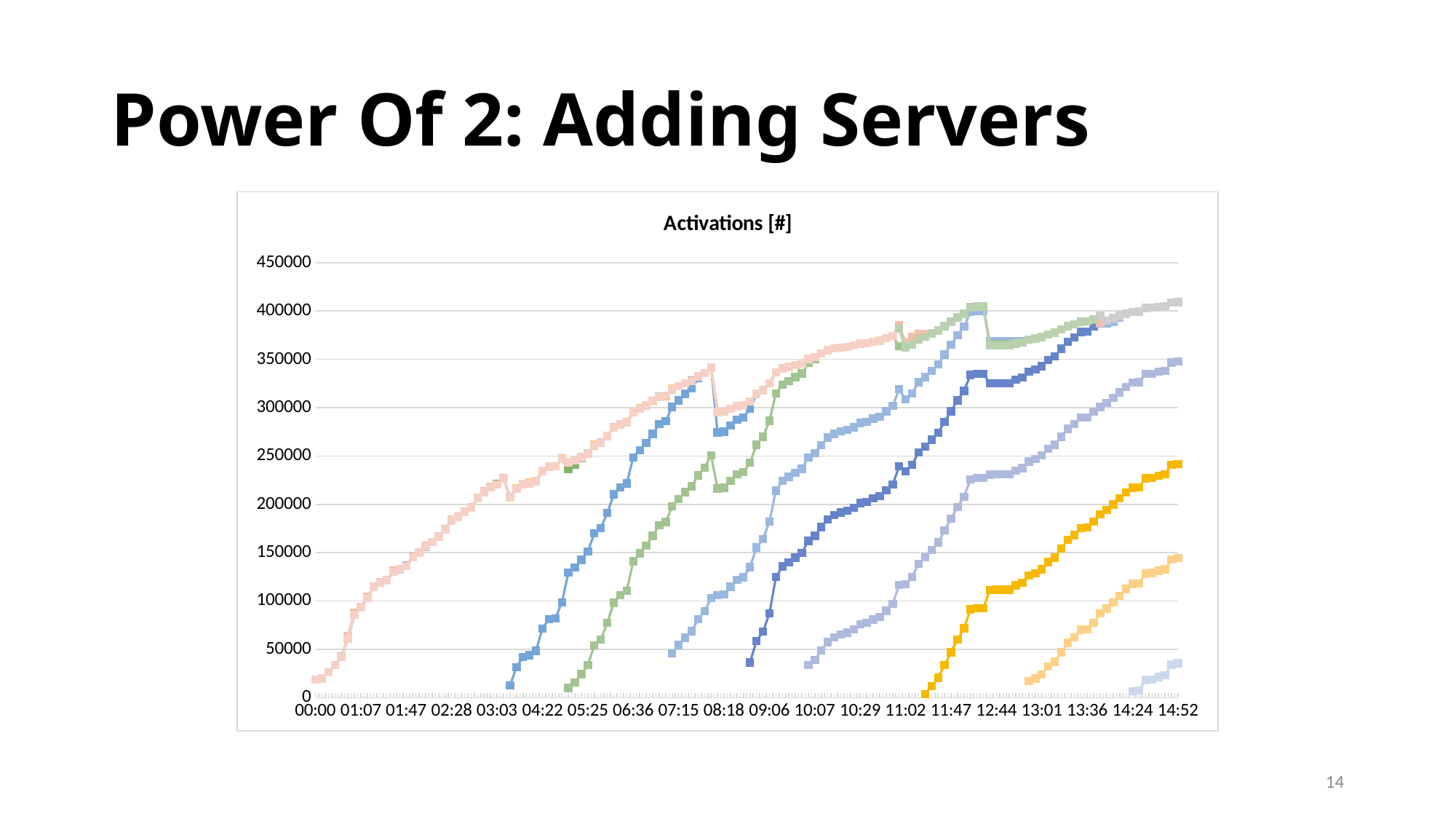
Is the final value of the light orange line at 14:52 greater or less than 100000? greater What kind of chart is shown on the slide? line chart What is the title of the chart? Activations [#] Is the final value of the pale blue line at 14:52 greater or less than 50000? less How many time labels are shown along the x axis of the chart? 20 Is the final value of the gold line at 14:52 greater or less than 200000? greater Do the values of each line generally rise or fall as time moves along the x axis? rise What is the highest value shown on the y axis of the chart? 450000 At 14:52, which line is higher: the gold line or the light orange line? the gold line